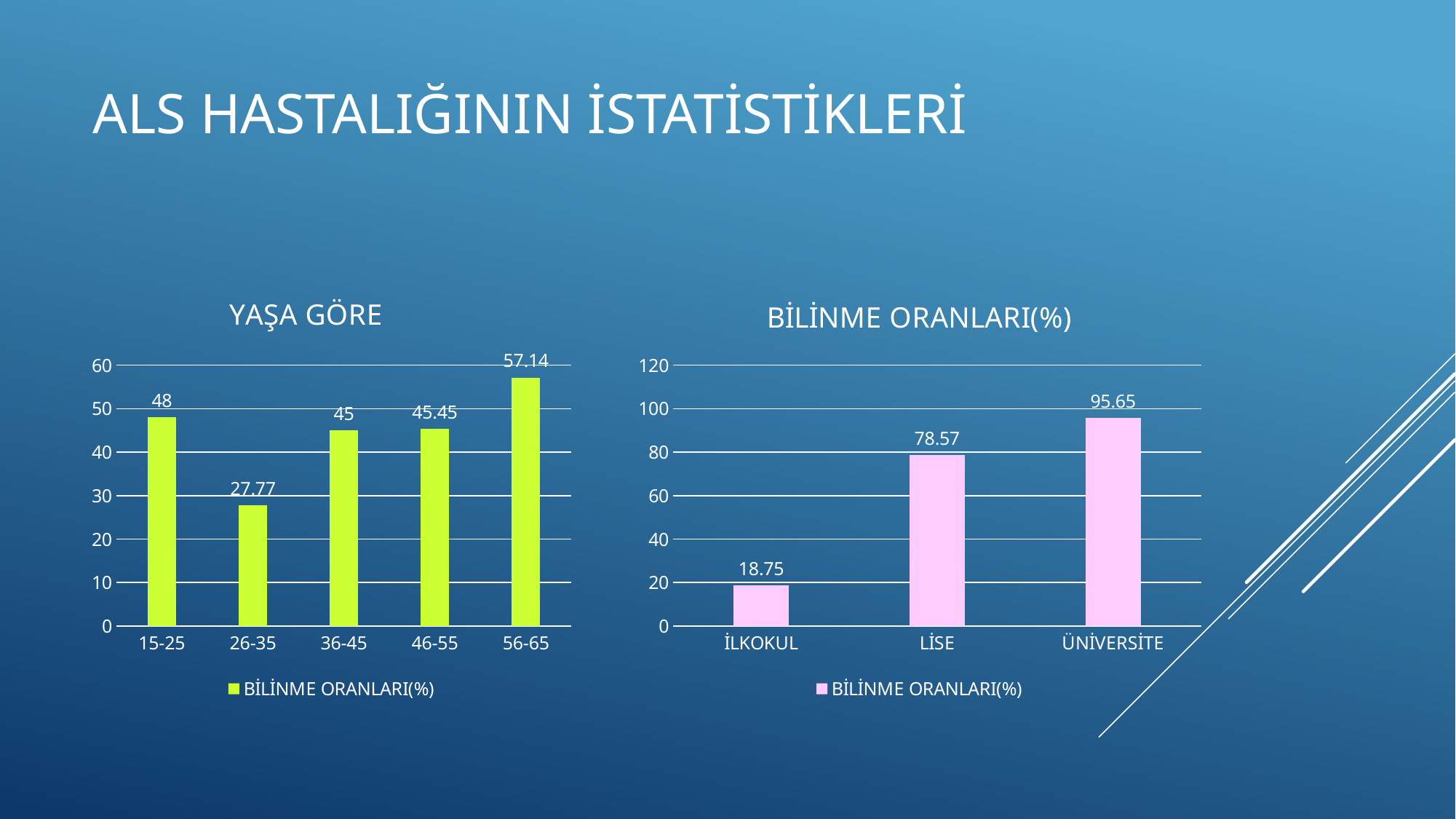
In the 'YAŞA GÖRE' chart, how many age groups are shown? 5 In the 'YAŞA GÖRE' chart, which age group has the lowest value? 26-35 In the 'YAŞA GÖRE' chart, which age group has the highest value? 56-65 In the 'BİLİNME ORANLARI(%)' chart, which category has the highest value? ÜNİVERSİTE In the 'YAŞA GÖRE' chart, how many series does the legend list? 1 In the 'YAŞA GÖRE' chart, what is the value for the 26-35 age group? 27.77 In the 'YAŞA GÖRE' chart, is the value for 15-25 larger than the value for 36-45? Yes In the 'YAŞA GÖRE' chart, what is the difference between the values for 56-65 and 15-25? 9.14 In the 'BİLİNME ORANLARI(%)' chart, what is the value for LİSE? 78.57 In the 'BİLİNME ORANLARI(%)' chart, what is the difference between the values for ÜNİVERSİTE and İLKOKUL? 76.9 What kind of chart is the 'BİLİNME ORANLARI(%)' chart? Bar chart In the 'BİLİNME ORANLARI(%)' chart, do the values rise or fall from İLKOKUL to ÜNİVERSİTE? Rise